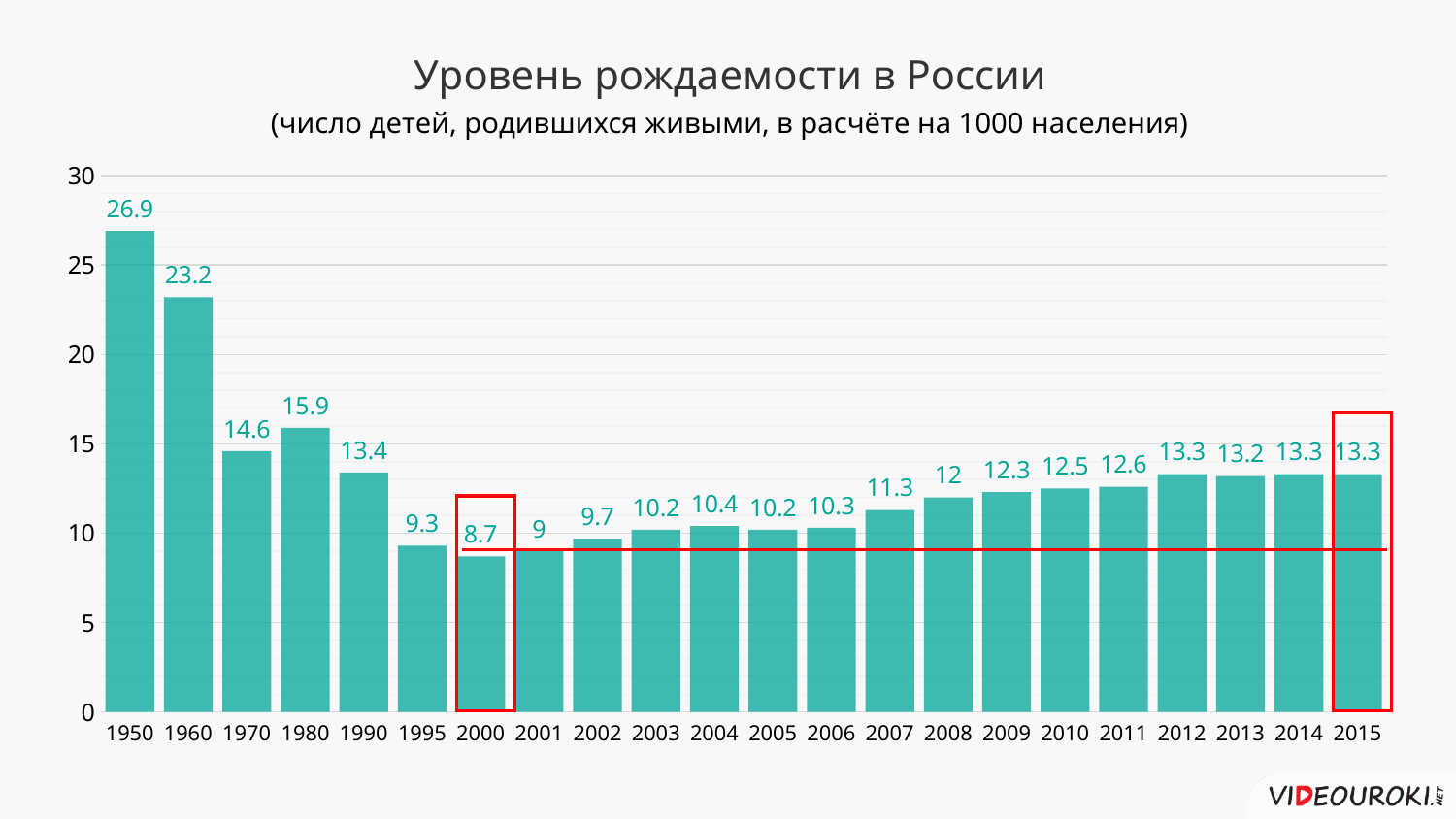
What is the birth rate value shown for 1950? 26.9 Is the value for 1990 greater or less than 10? greater What is the value shown for 2008? 12 What is the difference between the values for 1950 and 1960? 3.7 What is the title of the chart? Уровень рождаемости в России Which year has the highest birth rate on the chart? 1950 What is the value shown for 2000? 8.7 Which is larger, the value for 1970 or the value for 1980? 1980 What is the difference between the values for 2015 and 2000? 4.6 How many years (bars) are shown on the chart? 22 Which year has the lowest birth rate on the chart? 2000 What kind of chart is shown on the slide? bar chart